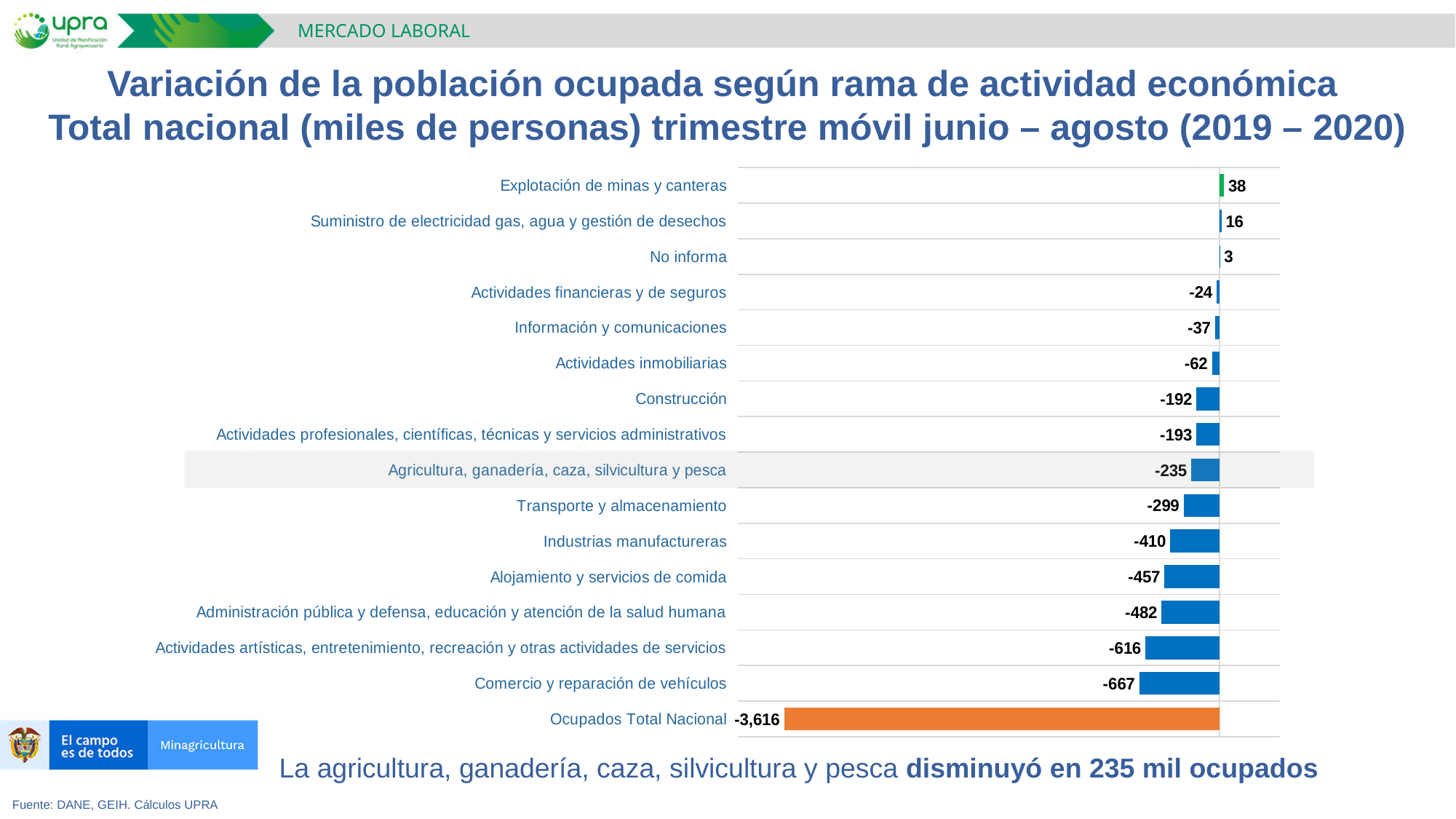
What is the value for Explotación de minas y canteras? 38 What is the value for Comercio y reparación de vehículos? -667 What is the value for Agricultura, ganadería, caza, silvicultura y pesca? -235 What is the value for Ocupados Total Nacional? -3,616 Which category has the highest value? Explotación de minas y canteras How many categories are shown in the chart? 16 What is the difference between the values for Comercio y reparación de vehículos and Agricultura, ganadería, caza, silvicultura y pesca? 432 What colour is the bar for Ocupados Total Nacional? Orange What kind of chart is shown on the slide? Bar chart Which category has the lowest value? Ocupados Total Nacional Which is larger, the value for Transporte y almacenamiento or the value for Alojamiento y servicios de comida? Transporte y almacenamiento What is the value for Industrias manufactureras? -410